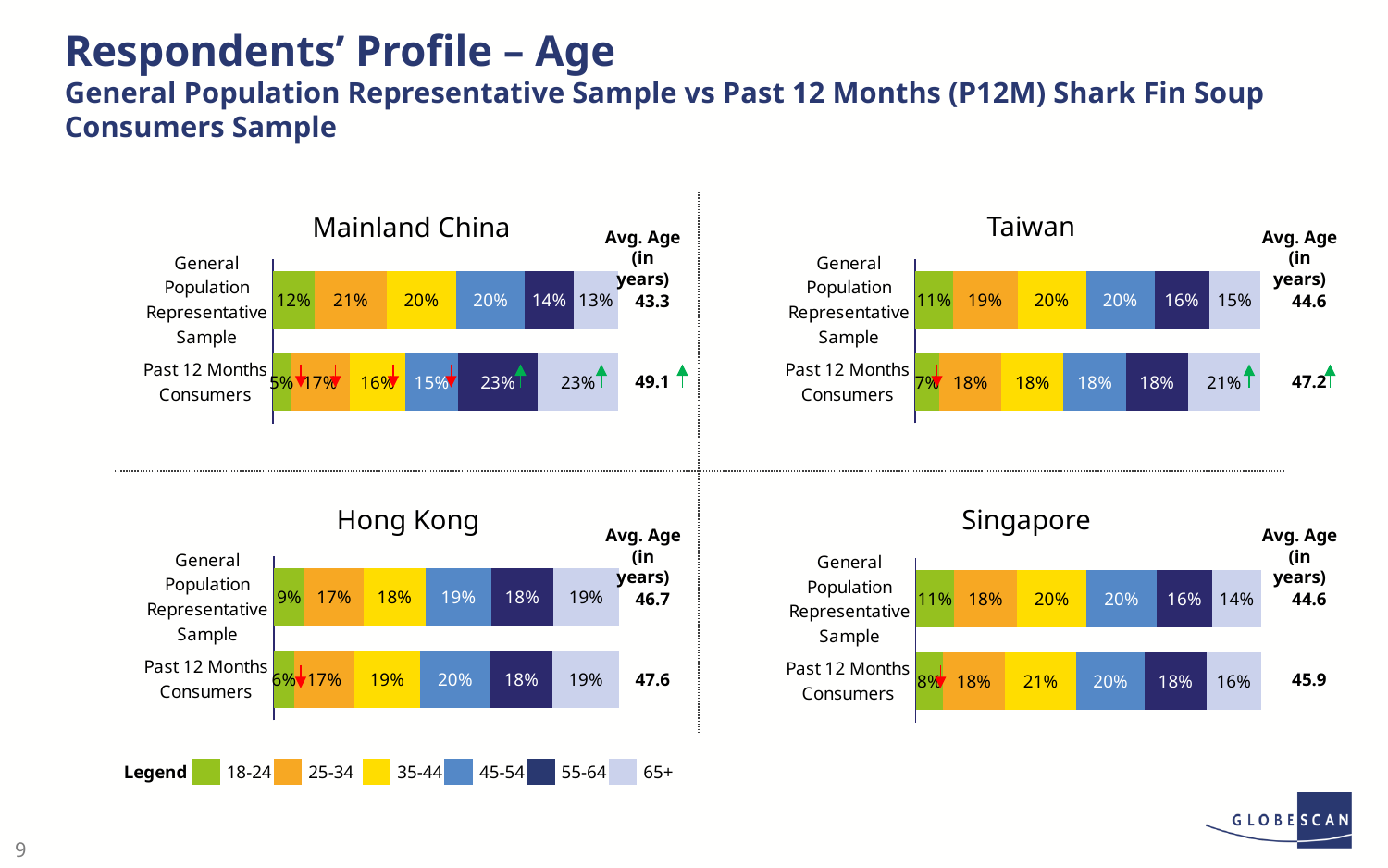
In the Hong Kong chart, which group has the higher average age: the General Population Representative Sample or Past 12 Months Consumers? Past 12 Months Consumers How many age groups does the legend list? 6 Which colour represents the 35-44 age group in the legend? Yellow What type of chart is used for each country on this slide? Stacked bar chart In the Singapore chart, what share of Past 12 Months Consumers is aged 35-44? 21% In the Mainland China chart, which age group has the largest share of the General Population Representative Sample? 25-34 In the Mainland China chart, what is the average age (in years) of Past 12 Months Consumers? 49.1 In the Taiwan chart, what share of Past 12 Months Consumers is aged 65+? 21% In the Singapore chart, which age group has the smallest share of Past 12 Months Consumers? 18-24 In the Hong Kong chart, what share of the General Population Representative Sample is aged 18-24? 9% In the Mainland China chart, what share of the General Population Representative Sample is aged 25-34? 21% In the Mainland China chart, what is the difference in average age between Past 12 Months Consumers and the General Population Representative Sample? 5.8